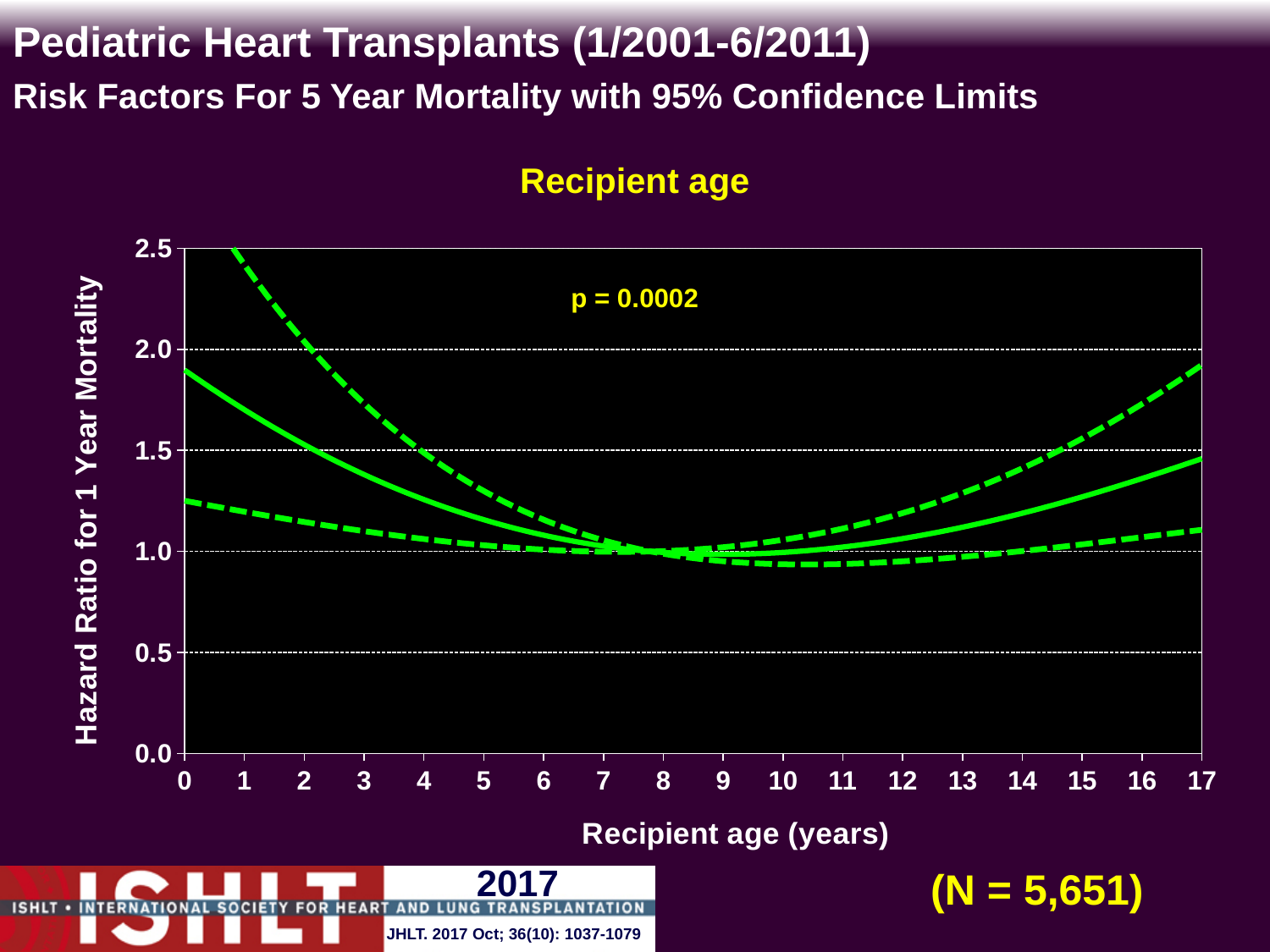
Does the solid hazard ratio line rise or fall between recipient age 10 and recipient age 17? rise Is the value of the solid hazard ratio line at recipient age 0 greater or less than 1.5? greater What is the title of the chart? Recipient age What kind of chart is shown on the slide? line chart Is the value of the upper dashed confidence limit at recipient age 17 greater or less than 1.5? greater Is the value of the lower dashed confidence limit at recipient age 0 greater or less than 1.5? less How many lines are plotted on the chart? 3 How many tick labels are shown on the x axis (Recipient age in years)? 18 Does the solid hazard ratio line rise or fall between recipient age 0 and recipient age 7? fall What is the label of the y axis? Hazard Ratio for 1 Year Mortality Which is larger for the solid hazard ratio line: the value at recipient age 0 or at recipient age 17? recipient age 0